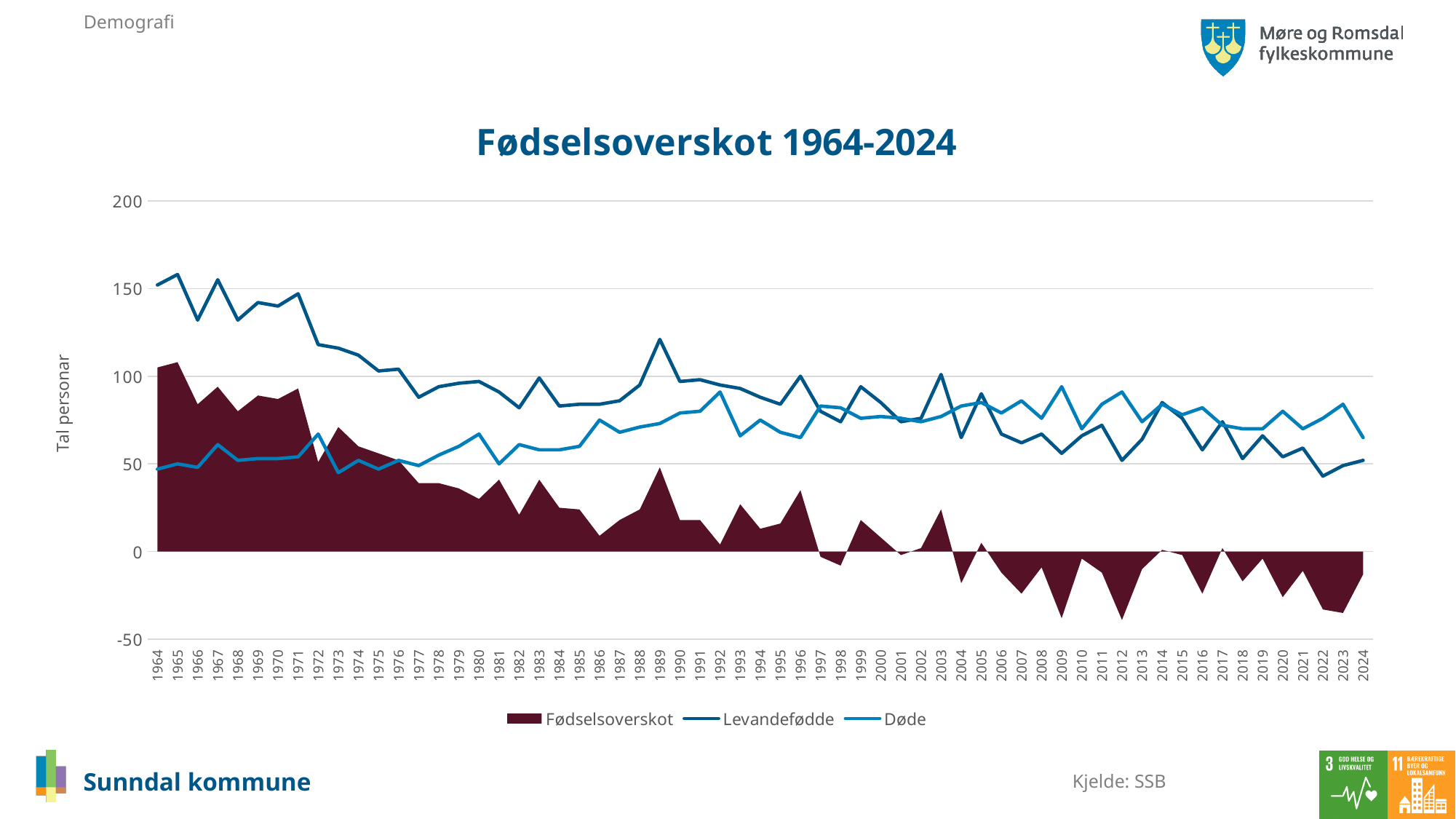
Is the value for Levandefødde in 1965 greater or less than 150? greater Does the Levandefødde series generally rise or fall from 1964 to 2024? fall Does the Døde series generally rise or fall from 1964 to 2024? rise How many years are plotted along the x axis? 61 What is the label on the vertical axis? Tal personar What is the title of the chart? Fødselsoverskot 1964-2024 Is the value for Fødselsoverskot in 2012 greater or less than 0? less Which series has the larger value in 2012, Levandefødde or Døde? Døde How many series does the legend list? 3 Is the value for Fødselsoverskot in 1964 greater or less than 100? greater